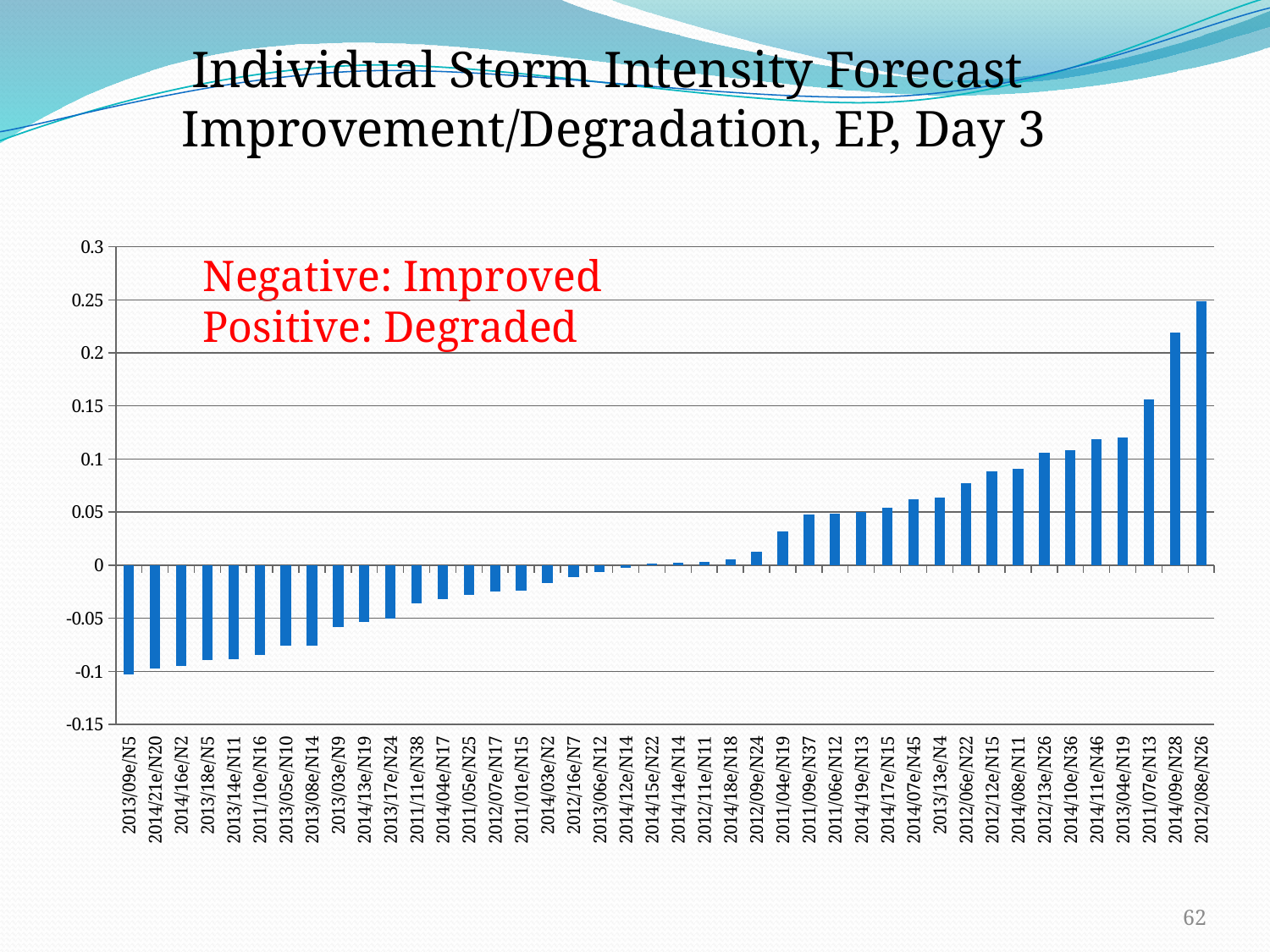
Is the value for 2013/09e/N5 greater or less than -0.05? less According to the red annotation on the chart, what does a negative value indicate? Improved How many storms (bars) are plotted in the chart? 42 What kind of chart is shown on the slide? Bar chart Which has the larger value, 2012/08e/N26 or 2014/09e/N28? 2012/08e/N26 Which storm has the lowest value in the chart? 2013/09e/N5 Is the value for 2014/21e/N20 greater or less than -0.05? less Is the value for 2011/07e/N13 greater or less than 0.1? greater Which storm has the highest value in the chart? 2012/08e/N26 Do the bar values rise or fall from left to right along the x axis? Rise